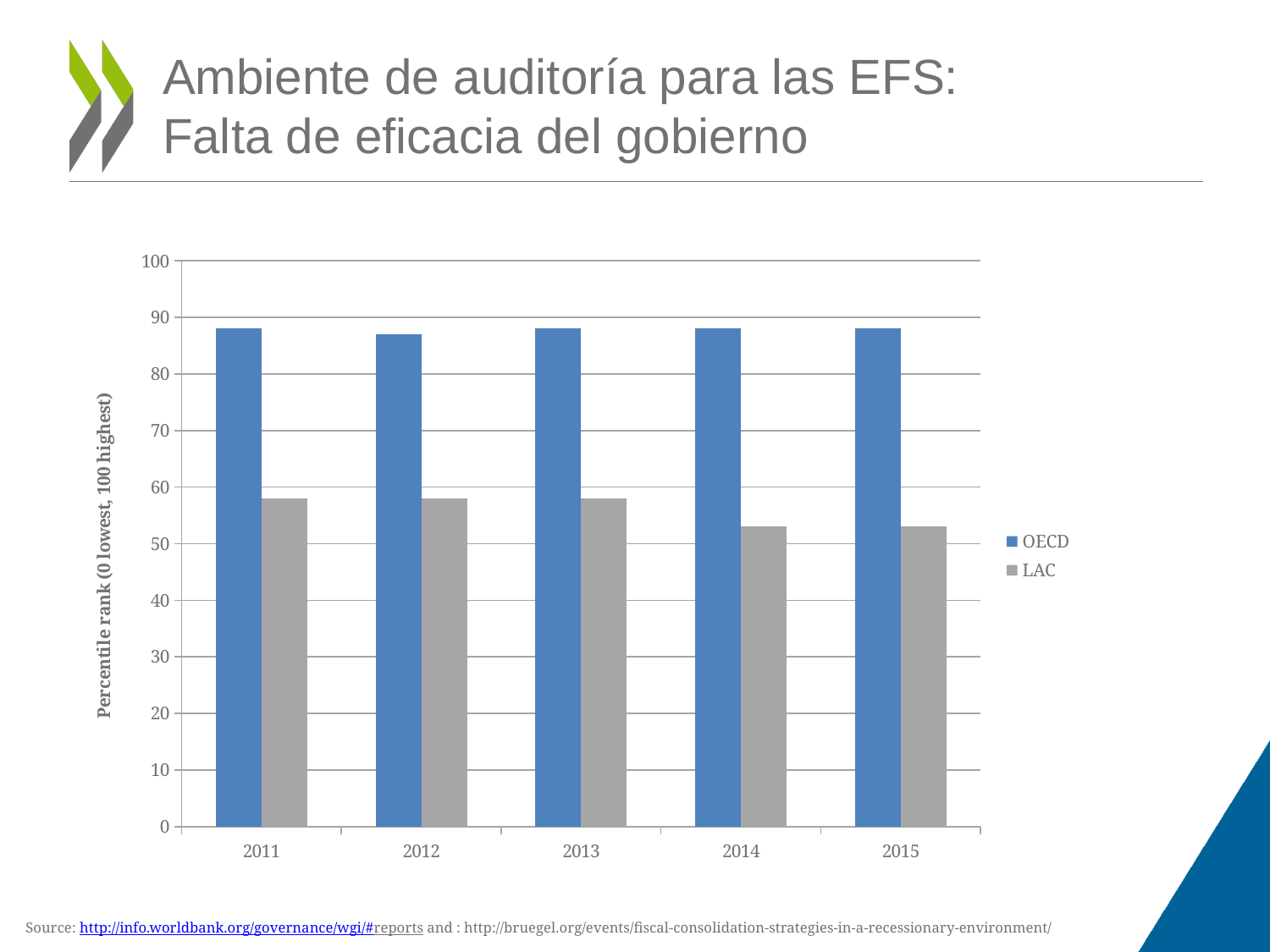
Is the value for LAC in 2012 greater or less than 50? greater Does the value for LAC rise or fall from 2013 to 2014? fall How many series does the legend list? 2 Which is larger in 2013, the value for OECD or the value for LAC? OECD Is the value for OECD in 2011 greater or less than 80? greater What is the label of the vertical axis? Percentile rank (0 lowest, 100 highest) Is the value for OECD in 2015 greater or less than 90? less Which series is listed first in the legend? OECD What kind of chart is shown on the slide? bar chart How many years are shown on the x axis? 5 Which is larger for LAC, the value in 2013 or the value in 2014? 2013